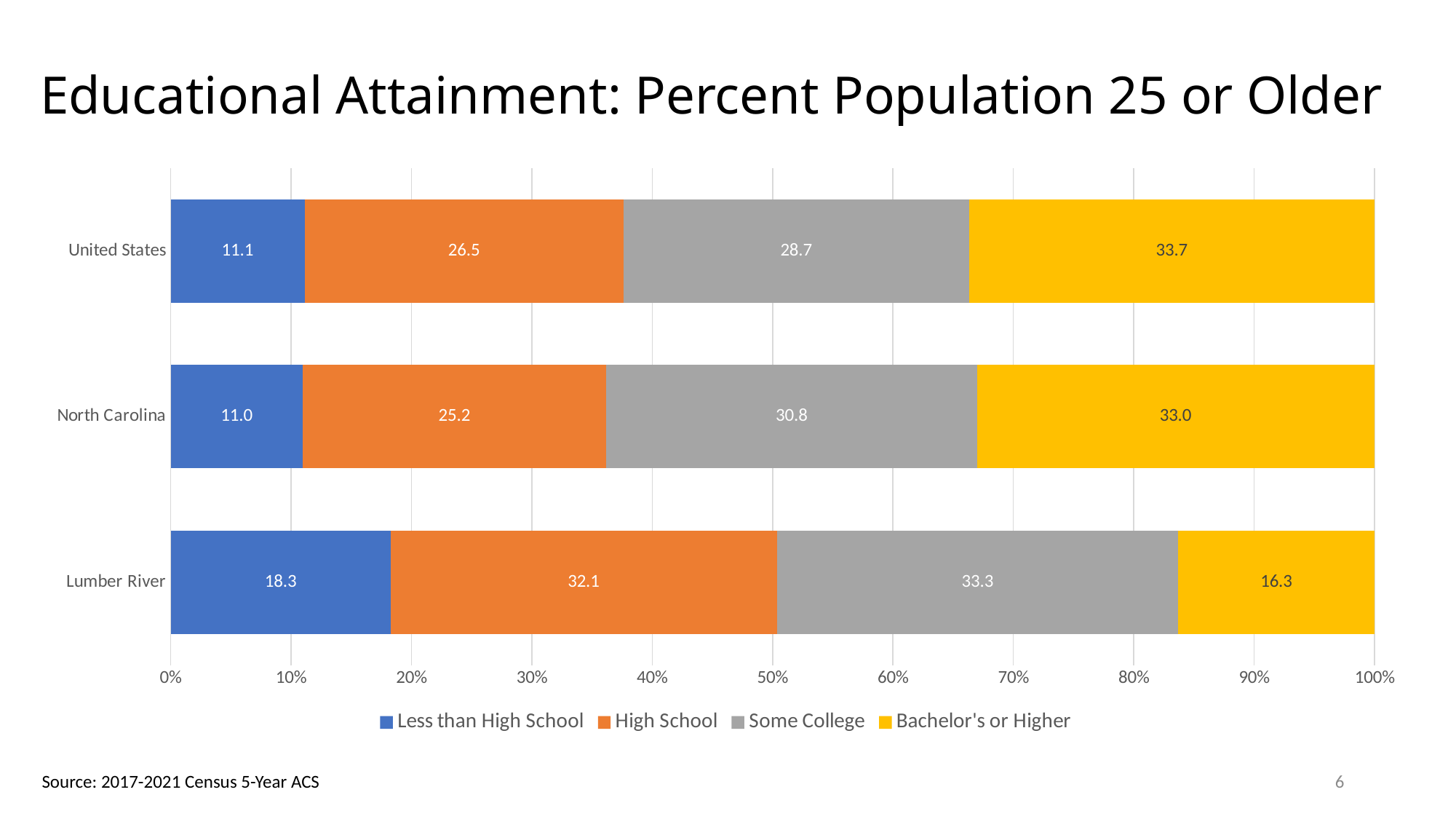
What is the difference between the Bachelor's or Higher values for the United States and Lumber River? 17.4 What is the title of the slide? Educational Attainment: Percent Population 25 or Older What is the value for Some College for North Carolina? 30.8 Which is larger: the High School value for North Carolina or for the United States? United States How many series does the legend list? 4 Which region has the lowest value for Bachelor's or Higher? Lumber River What is the value for Less than High School for Lumber River? 18.3 What is the value for Bachelor's or Higher for the United States? 33.7 What is the value for High School for Lumber River? 32.1 What kind of chart is shown on the slide? Stacked bar chart How many regions are shown on the chart? 3 Which region has the highest value for Less than High School? Lumber River